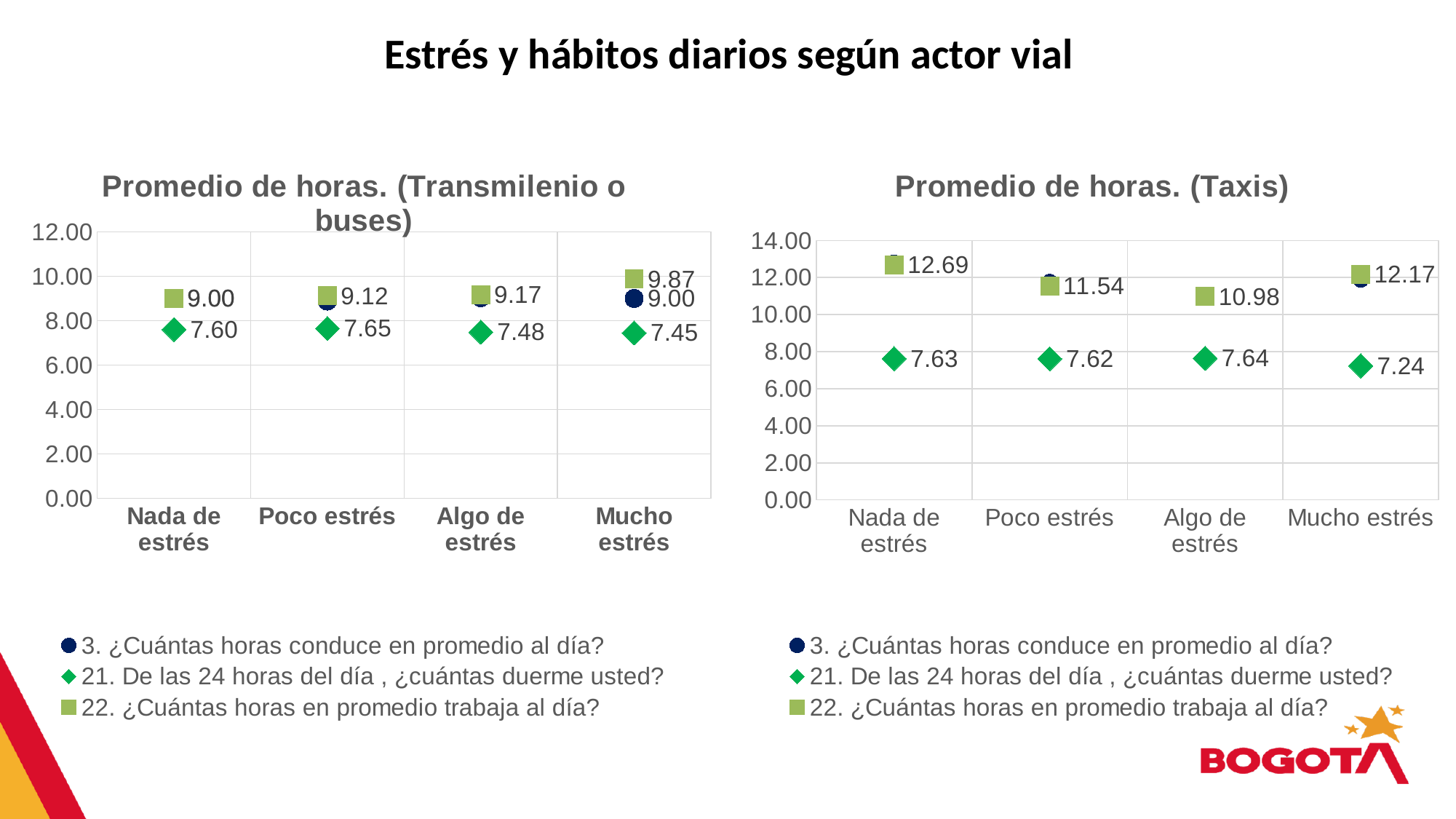
What is the title of the chart on the right side of the slide? Promedio de horas. (Taxis) How many series does the legend of the 'Promedio de horas. (Transmilenio o buses)' chart list? 3 In the 'Promedio de horas. (Taxis)' chart, which category has the highest value for '22. ¿Cuántas horas en promedio trabaja al día?'? Nada de estrés In the 'Promedio de horas. (Taxis)' chart, what is the value for 'Mucho estrés' in the series '21. De las 24 horas del día , ¿cuántas duerme usted?'? 7.24 In the 'Promedio de horas. (Taxis)' chart, what is the difference between the work-hours values for 'Nada de estrés' and 'Algo de estrés'? 1.71 In the 'Promedio de horas. (Transmilenio o buses)' chart, what is the value for 'Mucho estrés' in the series '22. ¿Cuántas horas en promedio trabaja al día?'? 9.87 In the 'Promedio de horas. (Transmilenio o buses)' chart, do the work-hours values rise or fall from 'Nada de estrés' to 'Mucho estrés'? rise In the 'Promedio de horas. (Taxis)' chart, what is the value for 'Nada de estrés' in the series '21. De las 24 horas del día , ¿cuántas duerme usted?'? 7.63 How many categories are shown on the x axis of the 'Promedio de horas. (Taxis)' chart? 4 In the 'Promedio de horas. (Taxis)' chart, is the work-hours value for 'Poco estrés' greater or less than 10.00? greater In the 'Promedio de horas. (Transmilenio o buses)' chart, which is larger for 'Mucho estrés': the work-hours value or the sleep-hours value? Work hours (9.87) In the 'Promedio de horas. (Transmilenio o buses)' chart, which category has the lowest value for '21. De las 24 horas del día , ¿cuántas duerme usted?'? Mucho estrés